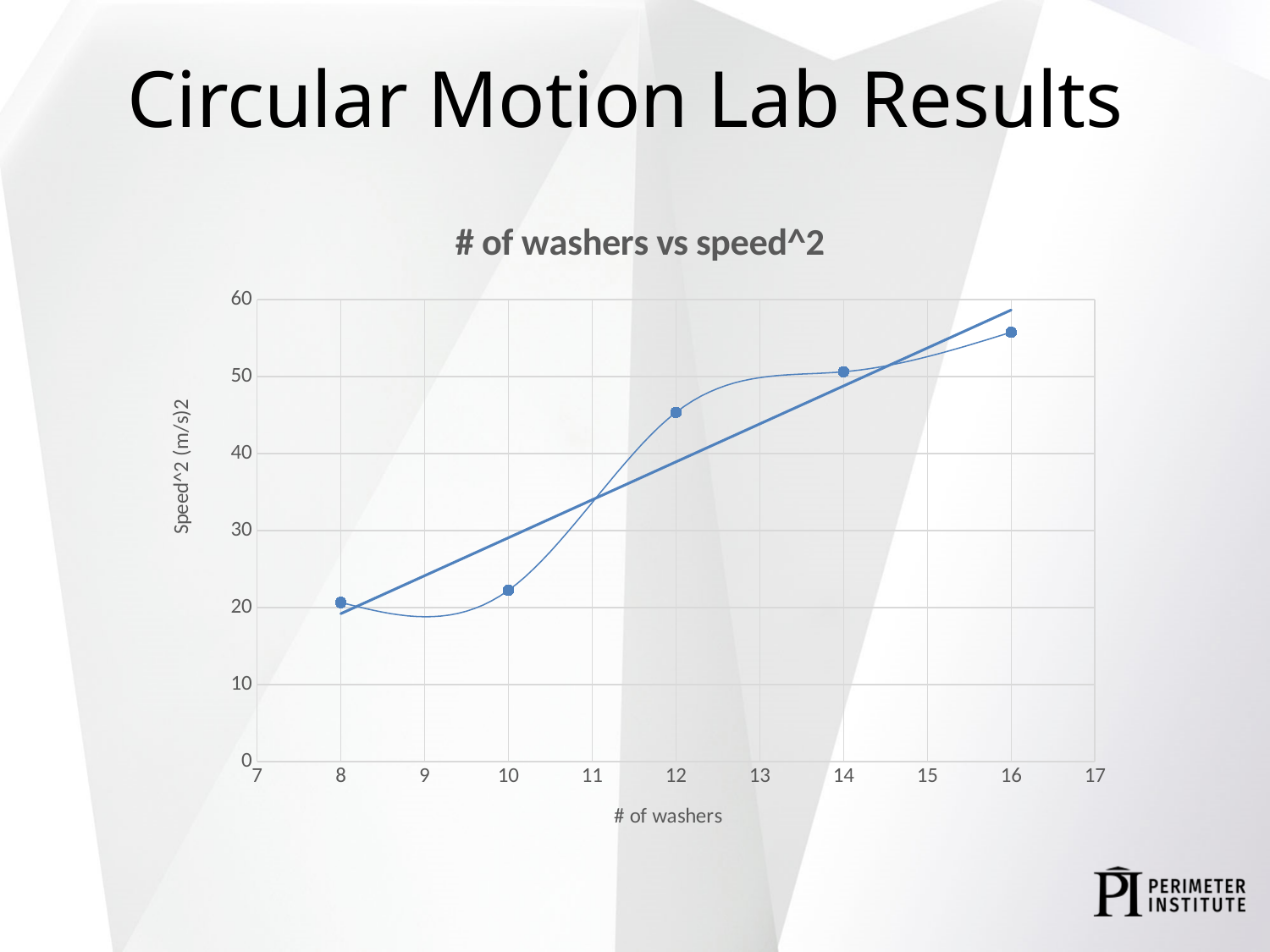
Which number of washers has the highest speed^2 value? 16 Is the value for 10 washers greater or less than 20? greater How many data points are plotted on the chart? 5 Which has the larger speed^2 value, 10 washers or 12 washers? 12 washers Is the value for 16 washers greater or less than 60? less Which number of washers has the lowest speed^2 value? 8 What kind of chart is shown on the slide? scatter chart with a smoothed line and a linear trendline Is the value for 12 washers greater or less than 40? greater Do the plotted values rise or fall as the number of washers increases? rise What is the title of the chart? # of washers vs speed^2